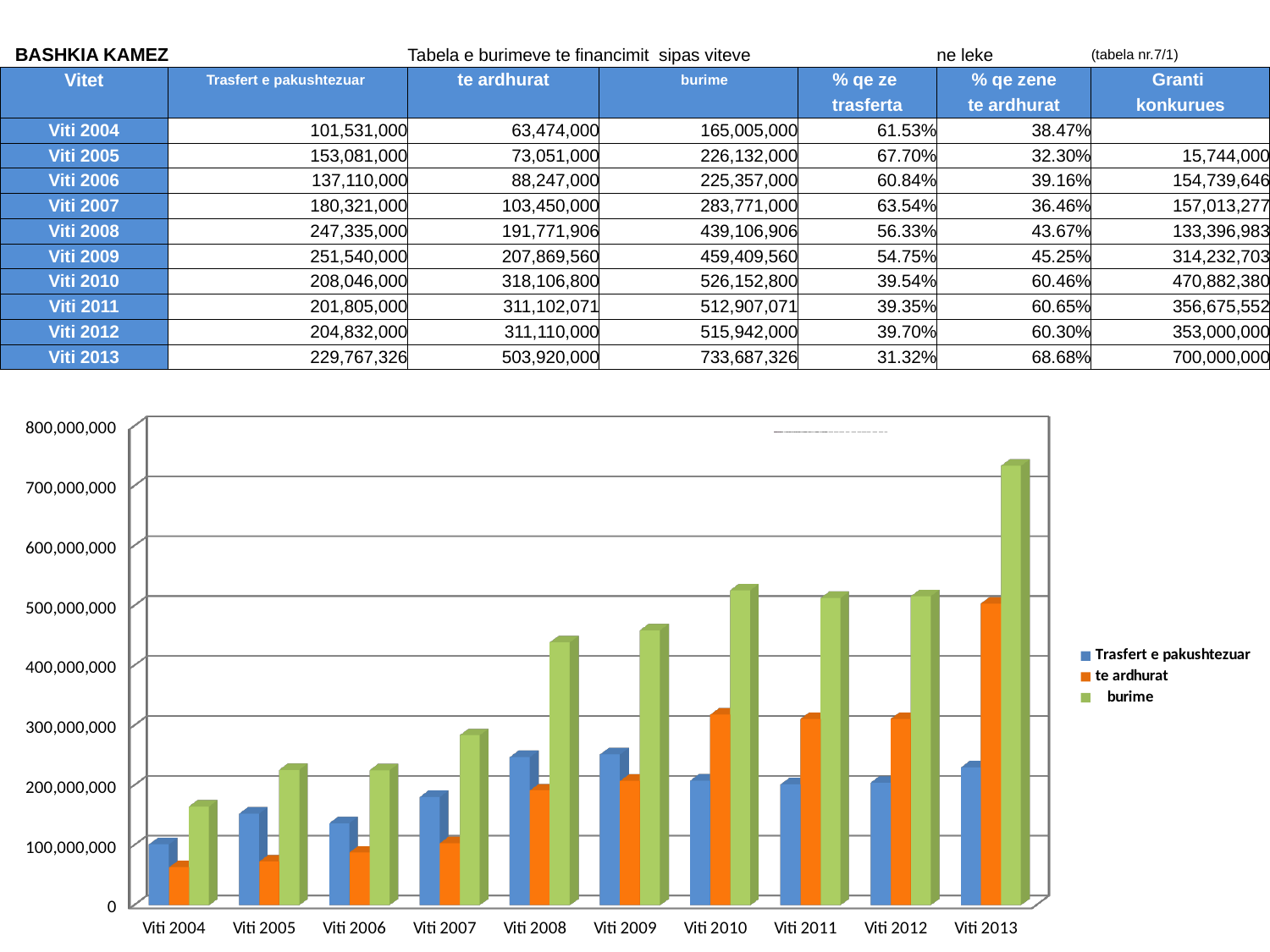
How many years (categories) are shown on the x axis of the chart? 10 What is the difference between the burime values for Viti 2013 and Viti 2012? 217,745,326 What is the burime value for Viti 2013? 733,687,326 For Viti 2010, which is larger: Trasfert e pakushtezuar or te ardhurat? te ardhurat What kind of chart is shown on the slide? bar chart What are the three legend entries of the chart? Trasfert e pakushtezuar, te ardhurat, burime For Viti 2009, which is larger: Trasfert e pakushtezuar or te ardhurat? Trasfert e pakushtezuar Is the te ardhurat value for Viti 2004 greater or less than 100,000,000? less Is the burime value for Viti 2013 greater or less than 700,000,000? greater How many series does the chart legend list? 3 Which year has the lowest burime bar in the chart? Viti 2004 Which year has the highest burime bar in the chart? Viti 2013